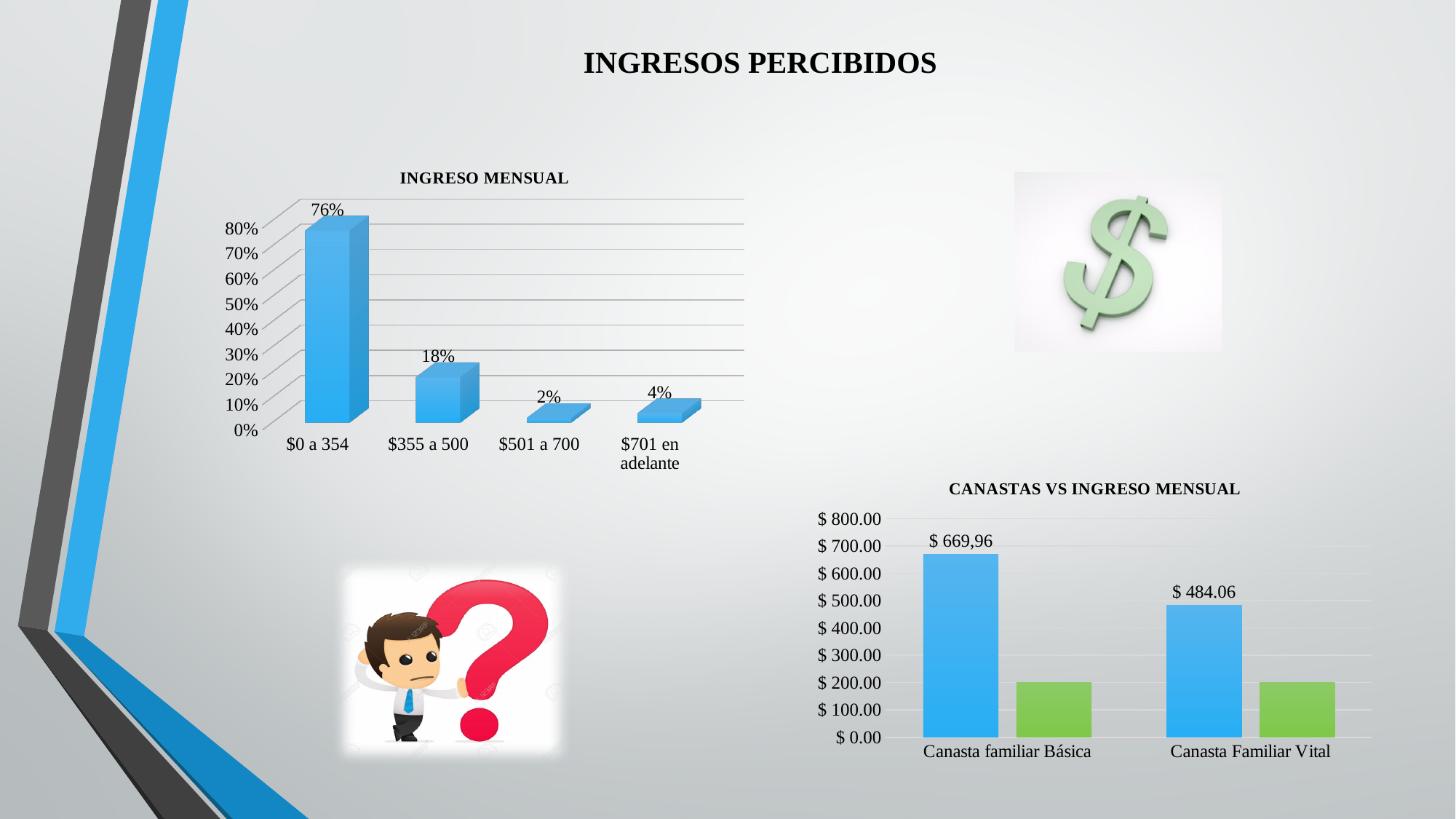
In the INGRESO MENSUAL chart, what is the difference between the values for $0 a 354 and $355 a 500? 58% What kind of chart is the INGRESO MENSUAL chart? Bar chart In the INGRESO MENSUAL chart, which category has the highest value? $0 a 354 In the CANASTAS VS INGRESO MENSUAL chart, what is the labelled value of the blue bar for Canasta Familiar Vital? $ 484.06 In the INGRESO MENSUAL chart, what is the value for the $355 a 500 category? 18% In the INGRESO MENSUAL chart, what is the value for the $0 a 354 category? 76% In the INGRESO MENSUAL chart, how many categories are shown on the x axis? 4 In the INGRESO MENSUAL chart, which category has the lowest value? $501 a 700 In the INGRESO MENSUAL chart, what is the value for the $701 en adelante category? 4% In the CANASTAS VS INGRESO MENSUAL chart, which blue bar is taller, Canasta familiar Básica or Canasta Familiar Vital? Canasta familiar Básica In the CANASTAS VS INGRESO MENSUAL chart, what is the labelled value of the blue bar for Canasta familiar Básica? $ 669,96 In the CANASTAS VS INGRESO MENSUAL chart, is the green bar for Canasta familiar Básica greater or less than $ 300.00? less